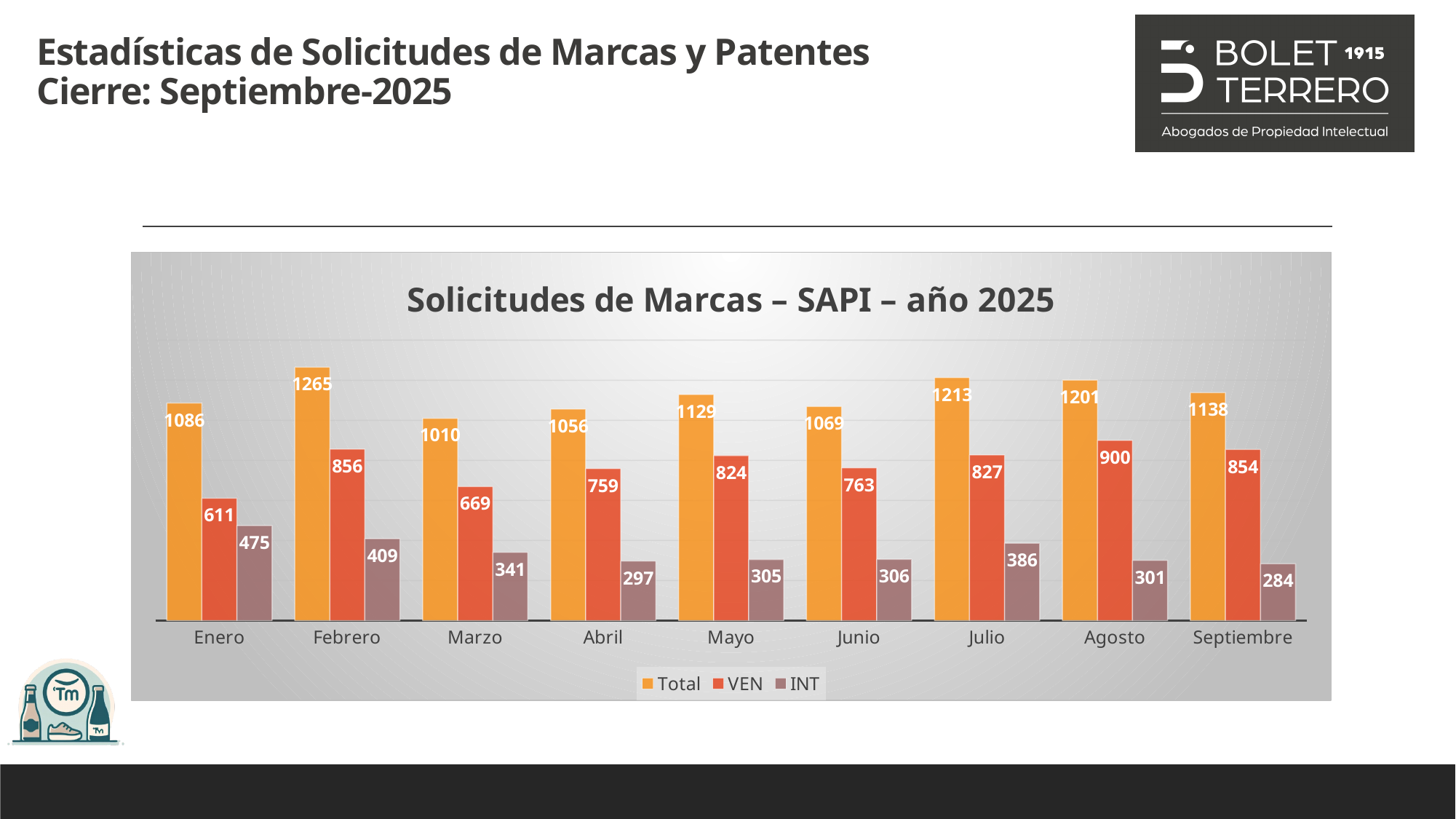
What is the INT value for Septiembre? 284 What is the Total value for Febrero? 1265 What is the VEN value for Agosto? 900 Which month has the highest Total value? Febrero What kind of chart is shown? Bar chart How many months are shown on the x axis? 9 Which month has the lowest Total value? Marzo What is the difference between the VEN values for Agosto and Enero? 289 What is the title of the chart? Solicitudes de Marcas – SAPI – año 2025 Which month has the highest INT value? Enero How many series does the legend list? 3 Which is larger, the Total value for Julio or the Total value for Agosto? Julio